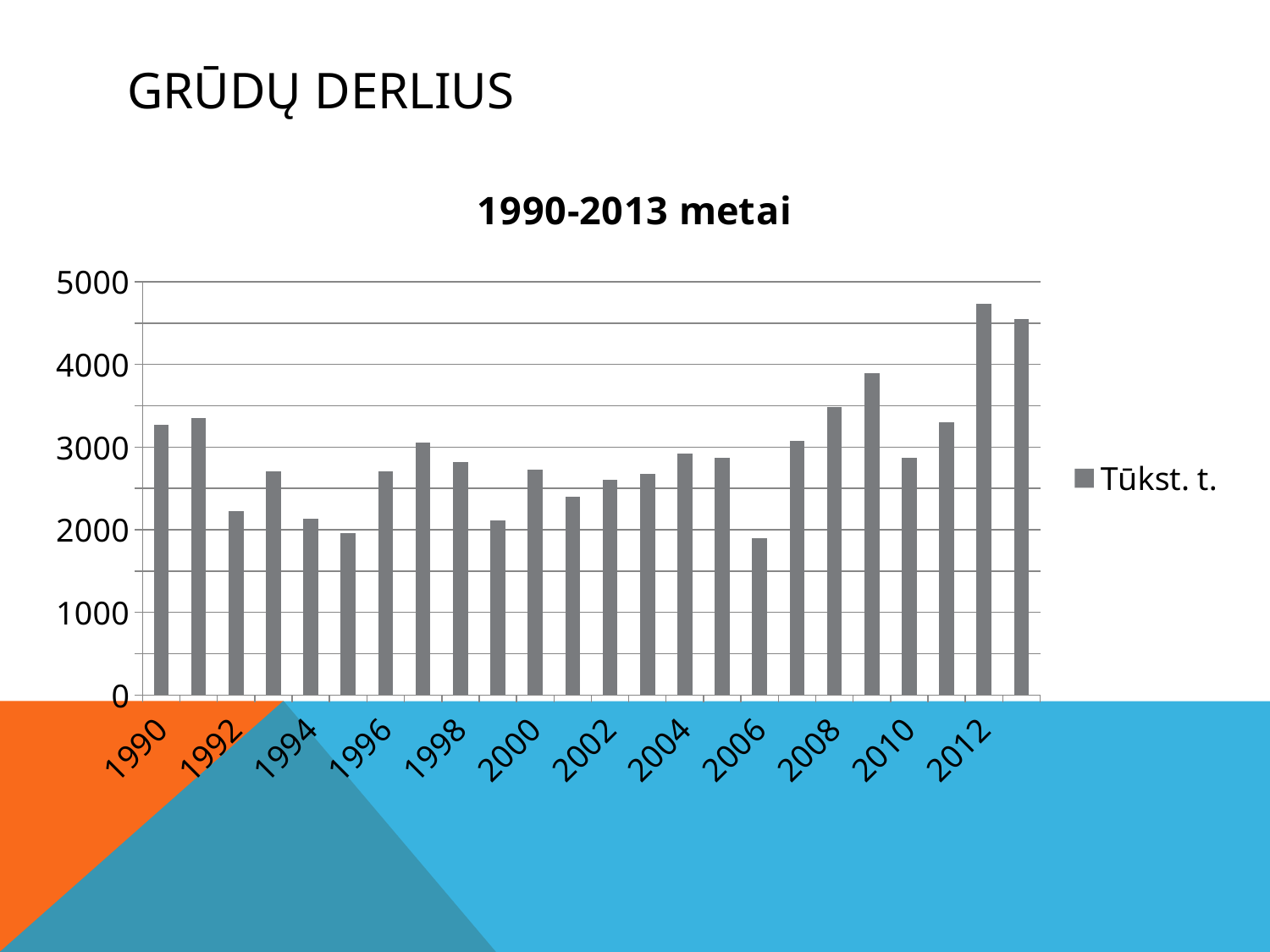
What entry does the chart's legend list? Tūkst. t. Is the value for 1992 greater or less than 3000? less Which year has the highest bar? 2012 What kind of chart is shown on the slide? bar chart How many series does the legend list? 1 Is the value for 1990 greater or less than 3000? greater How many bars are plotted in the chart? 24 Which is larger, the value for 2008 or the value for 2012? 2012 What is the title of the chart? 1990-2013 metai Is the value for 2006 greater or less than 2000? less Do the values rise or fall from 2006 to 2008? rise